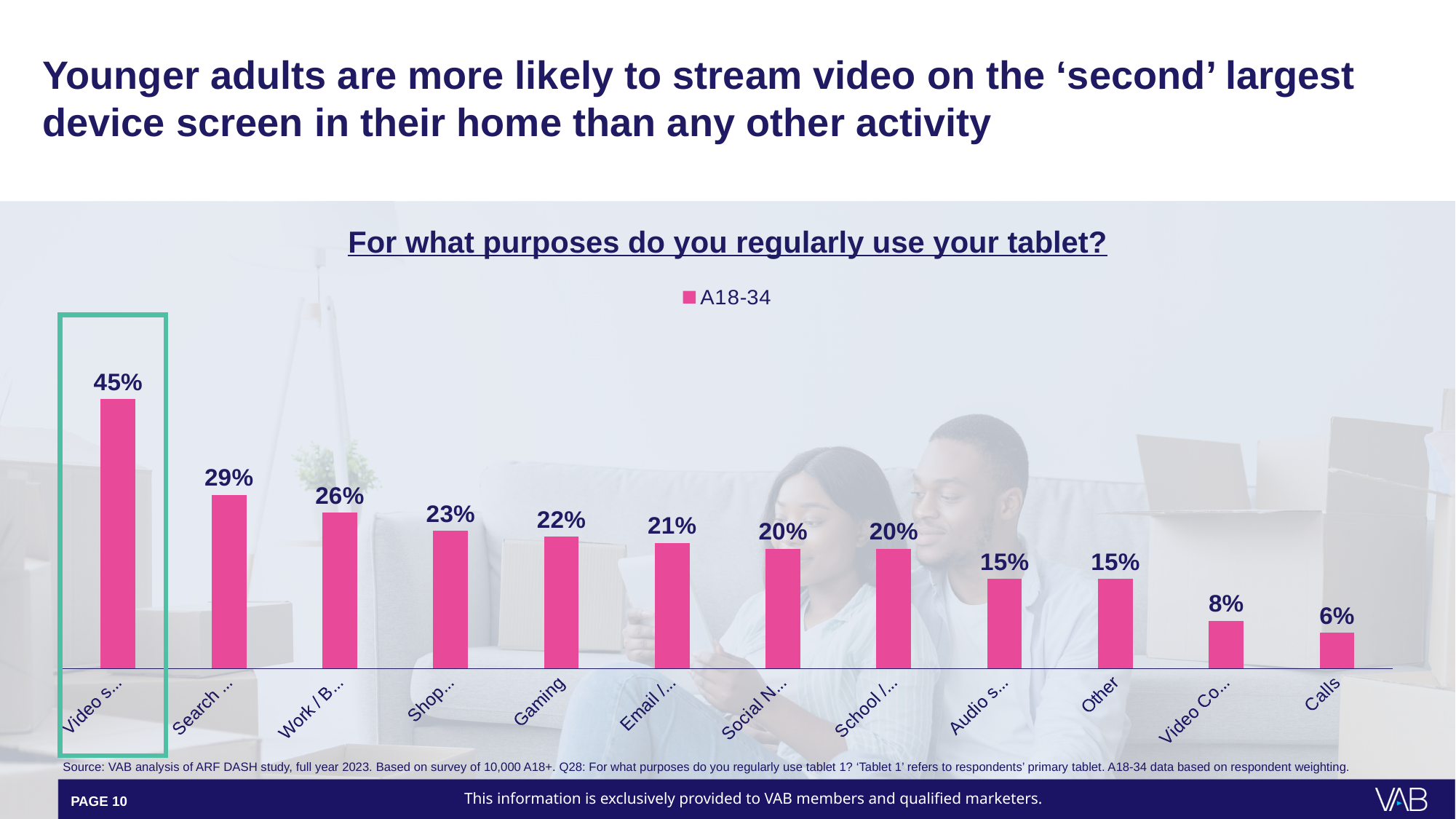
Which is larger, the value for Gaming or the value for Other? Gaming What kind of chart is shown on the slide? Bar chart What is the difference between the value for Gaming and the value for Calls? 16 percentage points Which category has the lowest value on the chart? Calls What value is shown for the Calls category? 6% How many categories are plotted on the chart? 12 How many series does the legend list? 1 What is the difference between the highest value on the chart and the value for Calls? 39 percentage points What percentage of A18-34 respondents regularly use their tablet for Gaming? 22% What value is shown for the Other category? 15% What is the highest value shown on the chart? 45% Do the values rise or fall moving from left to right along the x axis? Fall